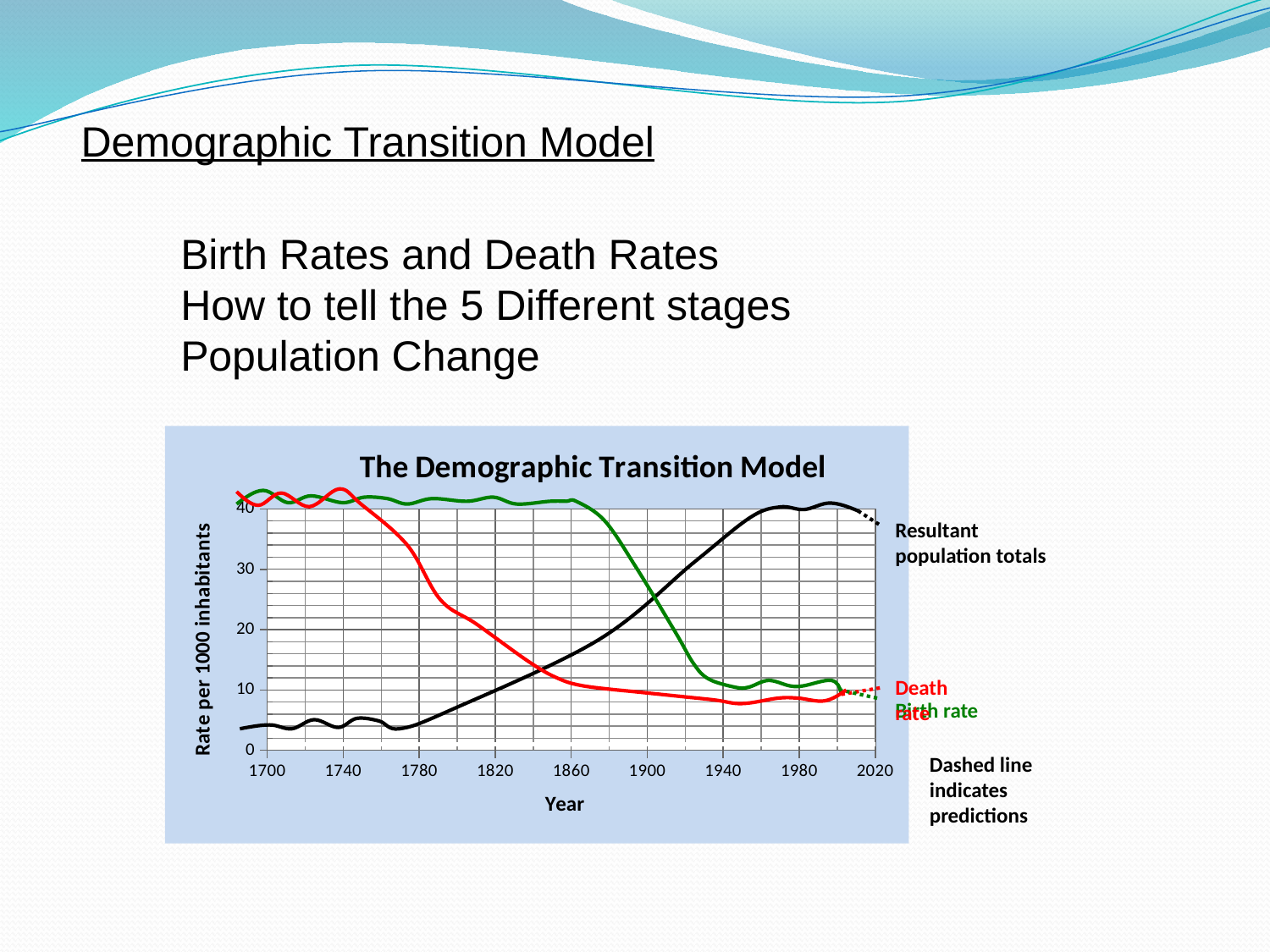
What is the title of the vertical axis on the Demographic Transition Model chart? Rate per 1000 inhabitants Is the death rate in 1900 greater or less than 20? less How many lines (series) are plotted on the Demographic Transition Model chart? 3 Is the resultant population total in 1980 greater or less than 30? greater Does the death rate rise or fall between 1740 and 1860? fall What kind of chart is "The Demographic Transition Model"? line chart According to the note on the slide, what does a dashed line on the chart indicate? predictions Is the resultant population total in 1700 greater or less than 10? less Does the resultant population total rise or fall between 1780 and 1960? rise In 1900, which is higher: the birth rate or the death rate? birth rate Does the birth rate rise or fall between 1860 and 1940? fall